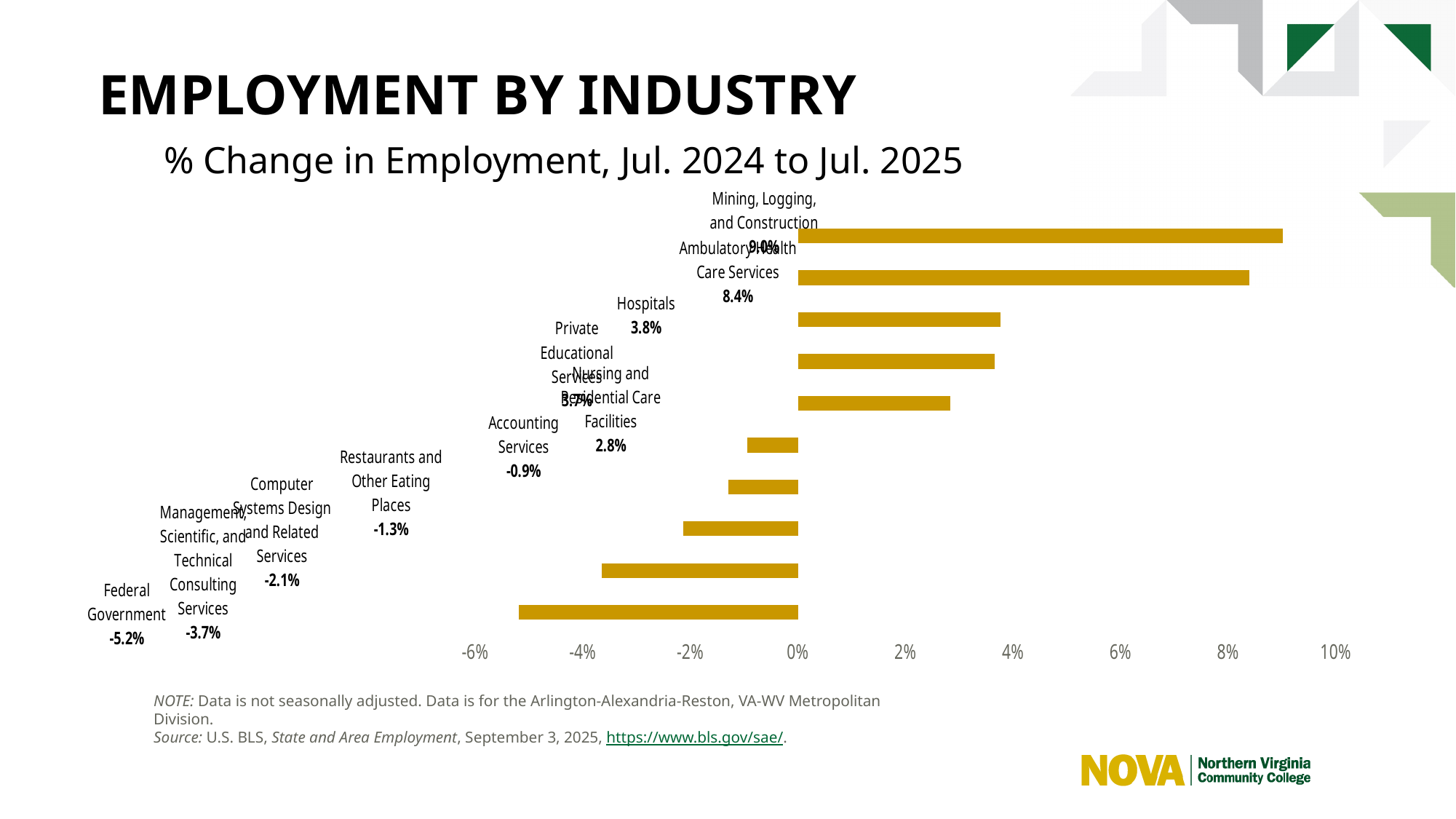
What is the difference in % change between Hospitals and Nursing and Residential Care Facilities? 1.0 percentage points What is the % change in employment for Hospitals? 3.8% What is the % change in employment for Computer Systems Design and Related Services? -2.1% What is the % change in employment for Nursing and Residential Care Facilities? 2.8% What is the % change in employment for Ambulatory Health Care Services? 8.4% Is the % change for Mining, Logging, and Construction greater or less than 8%? greater What is the % change in employment for Restaurants and Other Eating Places? -1.3% Which industry has the highest % change in employment? Mining, Logging, and Construction What type of chart is used to show the % change in employment? Bar chart How many industries are shown in the chart? 10 Which industry has the lowest % change in employment? Federal Government What is the % change in employment for Federal Government? -5.2%